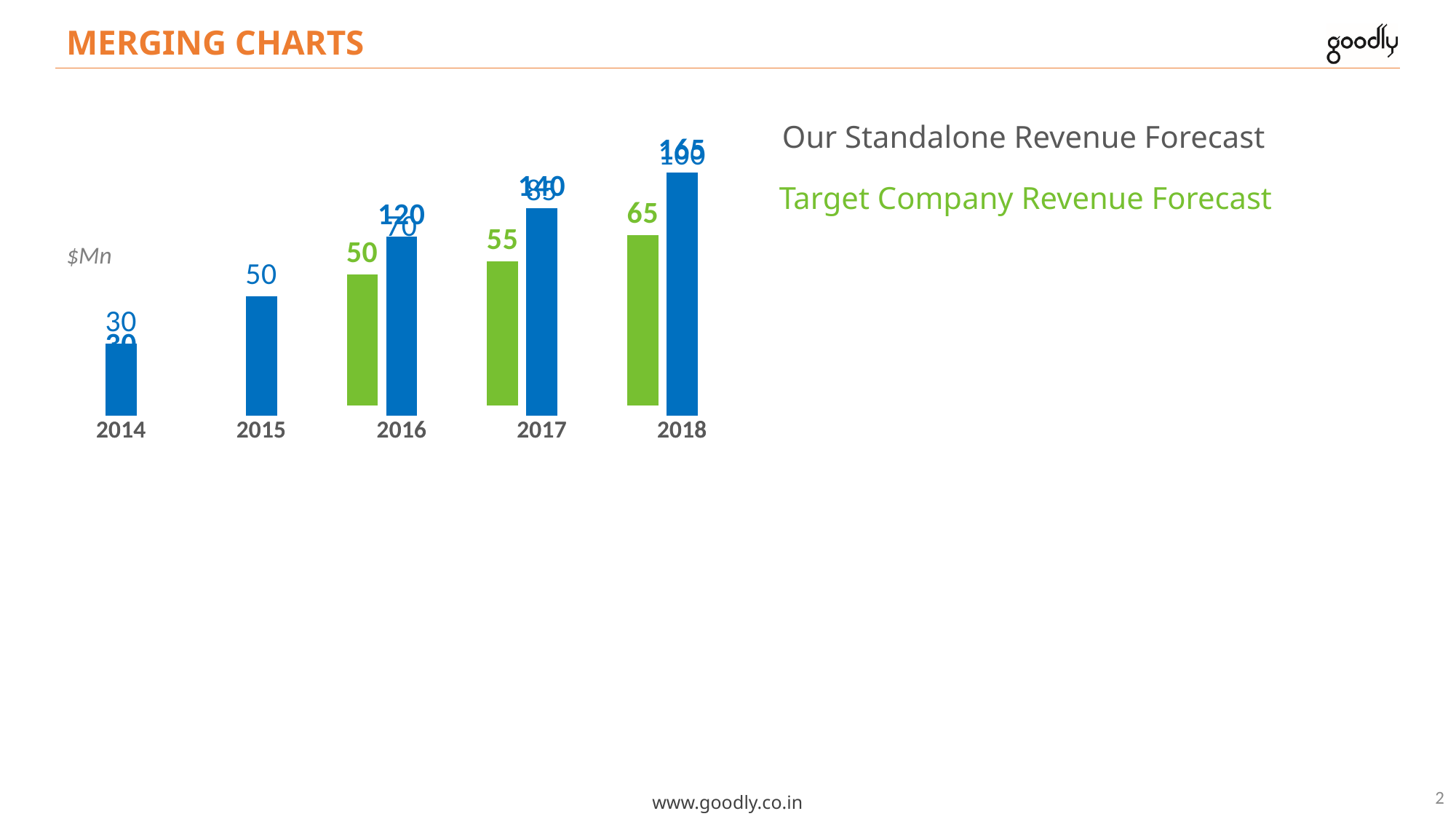
What is the Target Company Revenue Forecast value for 2017? 55 Which year has the highest Target Company Revenue Forecast? 2018 Which year has the lowest Target Company Revenue Forecast among the years where it is shown? 2016 How many years are shown on the x axis of the chart? 5 What kind of chart is shown on the slide? bar chart What is the Our Standalone Revenue Forecast value for 2015? 50 What is the Target Company Revenue Forecast value for 2016? 50 In 2018, which is larger: Our Standalone Revenue Forecast or Target Company Revenue Forecast? Our Standalone Revenue Forecast What unit label is shown next to the chart? $Mn What is the difference between the Target Company Revenue Forecast for 2018 and 2016? 15 Do the Target Company Revenue Forecast values rise or fall from 2016 to 2018? rise What is the Target Company Revenue Forecast value for 2018? 65